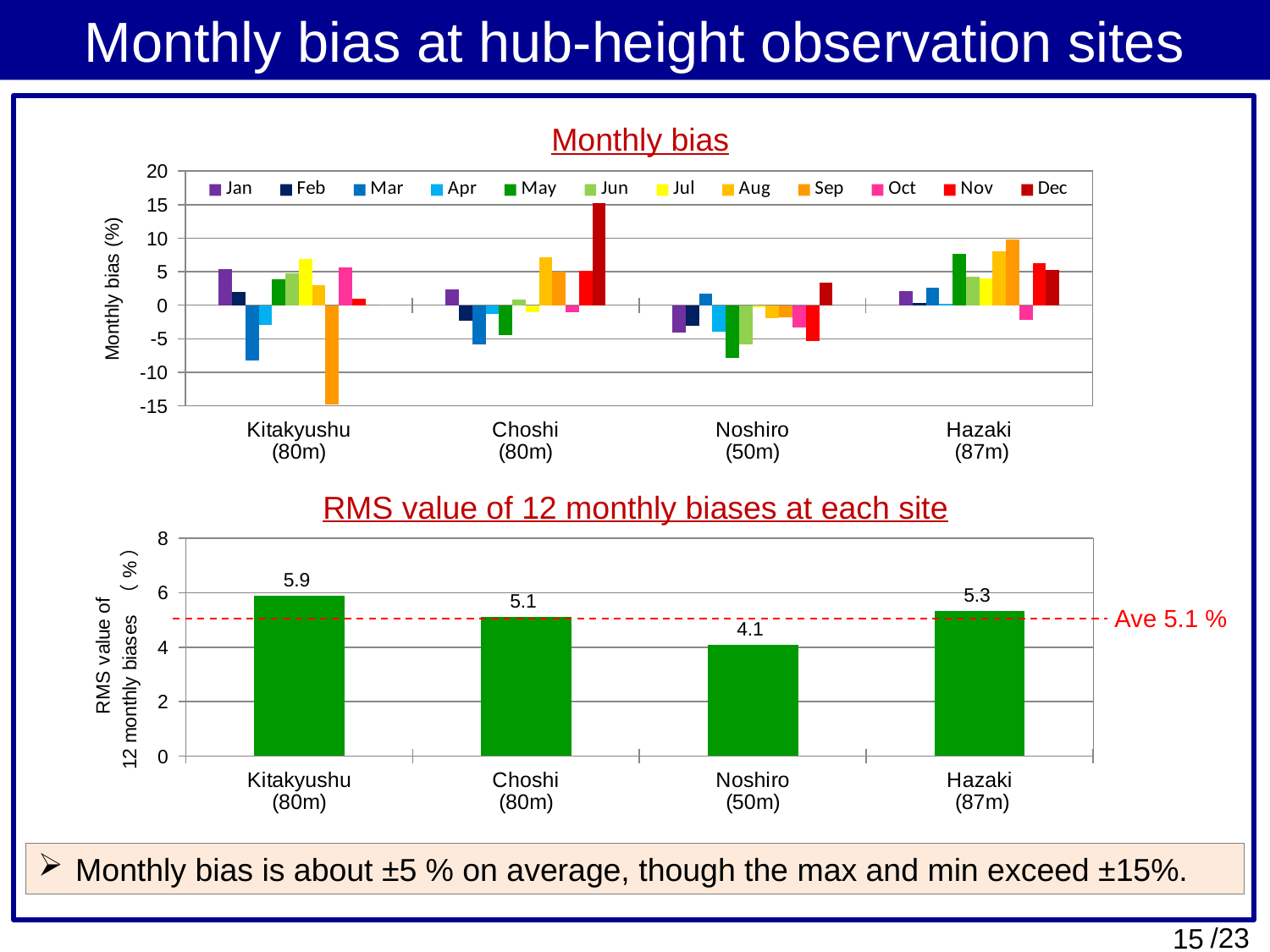
In the 'RMS value of 12 monthly biases at each site' chart, which site has the highest RMS value? Kitakyushu (80m) In the 'Monthly bias' chart, how many series does the legend list? 12 In the 'RMS value of 12 monthly biases at each site' chart, what is the value for Kitakyushu (80m)? 5.9 In the 'Monthly bias' chart, how many observation sites are shown on the x axis? 4 What kind of chart is the 'RMS value of 12 monthly biases at each site' chart? bar chart In the 'Monthly bias' chart, is the Sep value for Kitakyushu (80m) greater or less than -10? less In the 'RMS value of 12 monthly biases at each site' chart, what average value is marked by the dashed red line? Ave 5.1 % In the 'RMS value of 12 monthly biases at each site' chart, what is the difference between the values for Kitakyushu (80m) and Noshiro (50m)? 1.8 In the 'RMS value of 12 monthly biases at each site' chart, what is the value for Noshiro (50m)? 4.1 In the 'RMS value of 12 monthly biases at each site' chart, which site has the lowest RMS value? Noshiro (50m) In the 'Monthly bias' chart, is the Dec value for Choshi (80m) greater or less than 10? greater In the 'RMS value of 12 monthly biases at each site' chart, which is larger, the value for Hazaki (87m) or Choshi (80m)? Hazaki (87m)